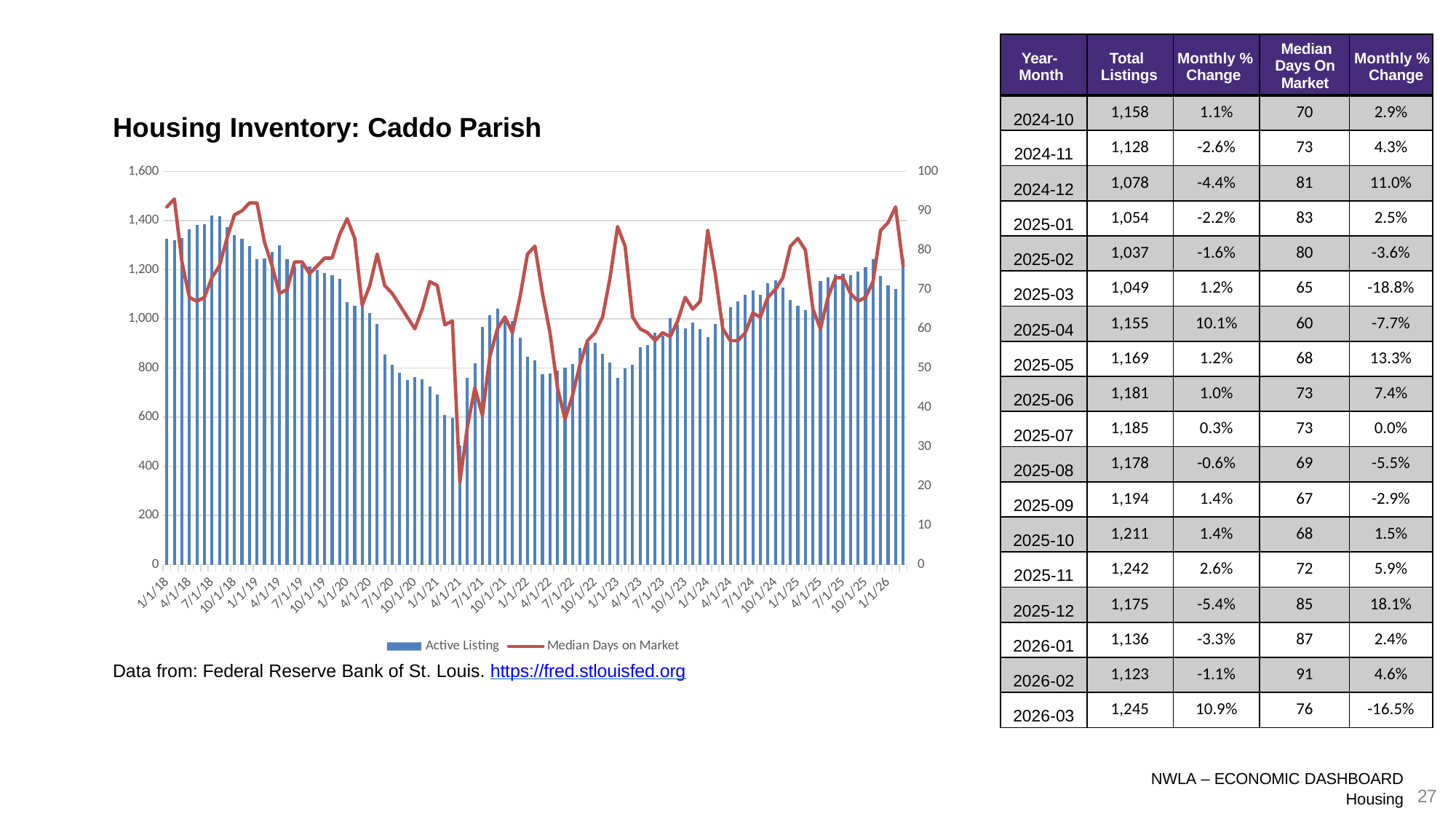
Which series is plotted as bars and which as a line? Active Listing is bars; Median Days on Market is the line Is the Active Listing value at 1/1/18 greater or less than 1,200? greater Is the Median Days on Market value at 7/1/22 greater or less than 50? less Do Active Listings generally rise or fall from 1/1/18 to 4/1/21? fall Do Active Listings generally rise or fall from 4/1/21 to 1/1/26? rise How many series does the chart legend list? 2 Is the Median Days on Market value at 1/1/19 greater or less than 80? greater What kind of chart is shown on the slide? A combined bar and line chart What is the title of the chart? Housing Inventory: Caddo Parish Around which date does the Median Days on Market line reach its lowest point? 4/1/21